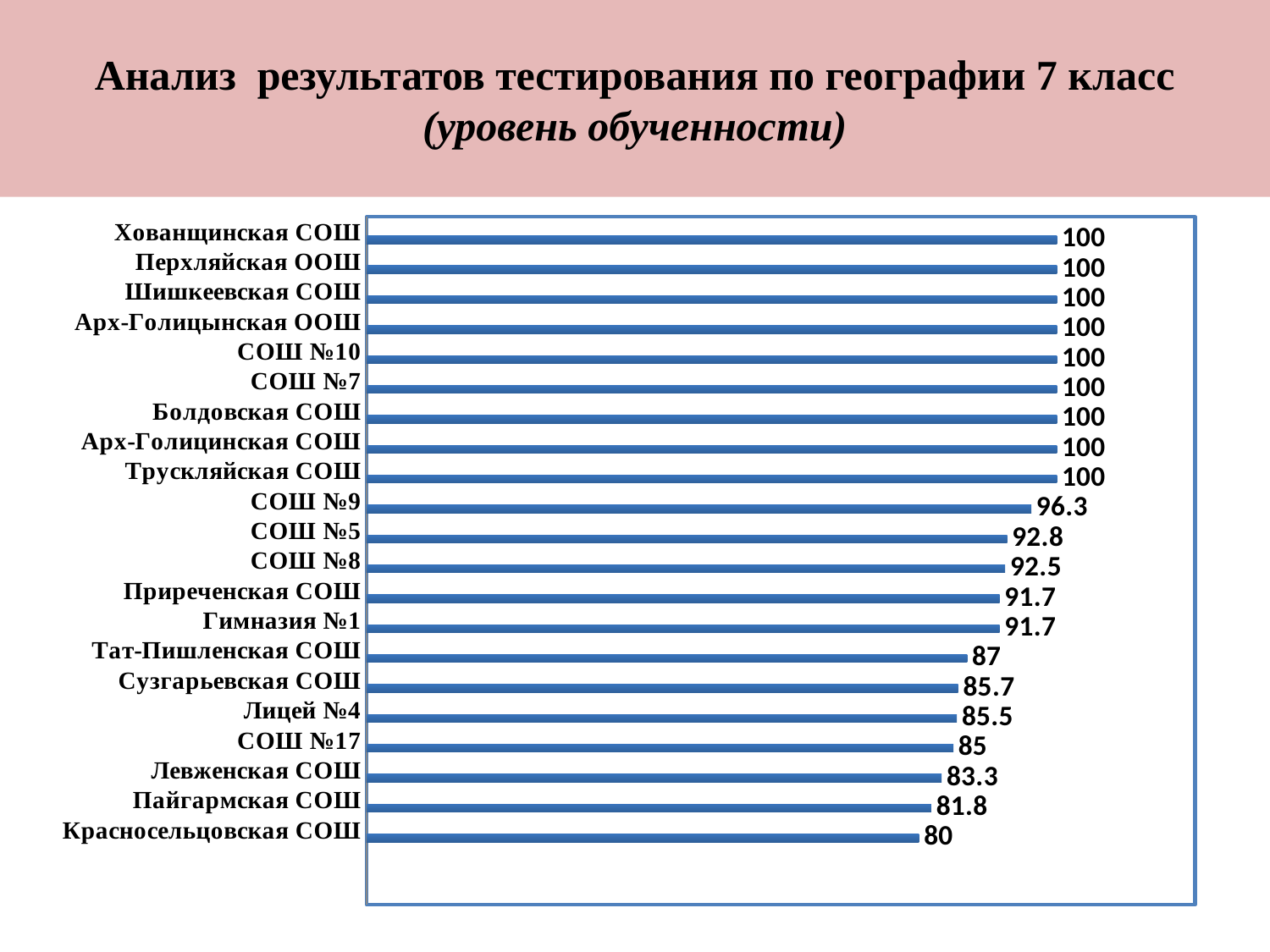
What is the difference between the values for СОШ №5 and СОШ №8? 0.3 What is the difference between the values for Хованщинская СОШ and Красносельцовская СОШ? 20 What is the value for Гимназия №1? 91.7 How many schools have a value of 100? 9 What kind of chart is shown on the slide? bar chart What is the value for Красносельцовская СОШ? 80 What is the value for Лицей №4? 85.5 What is the value for Тат-Пишленская СОШ? 87 How many schools are shown on the chart? 21 Which school has the lowest value on the chart? Красносельцовская СОШ What is the value for СОШ №9? 96.3 Which has a larger value, Левженская СОШ or Пайгармская СОШ? Левженская СОШ